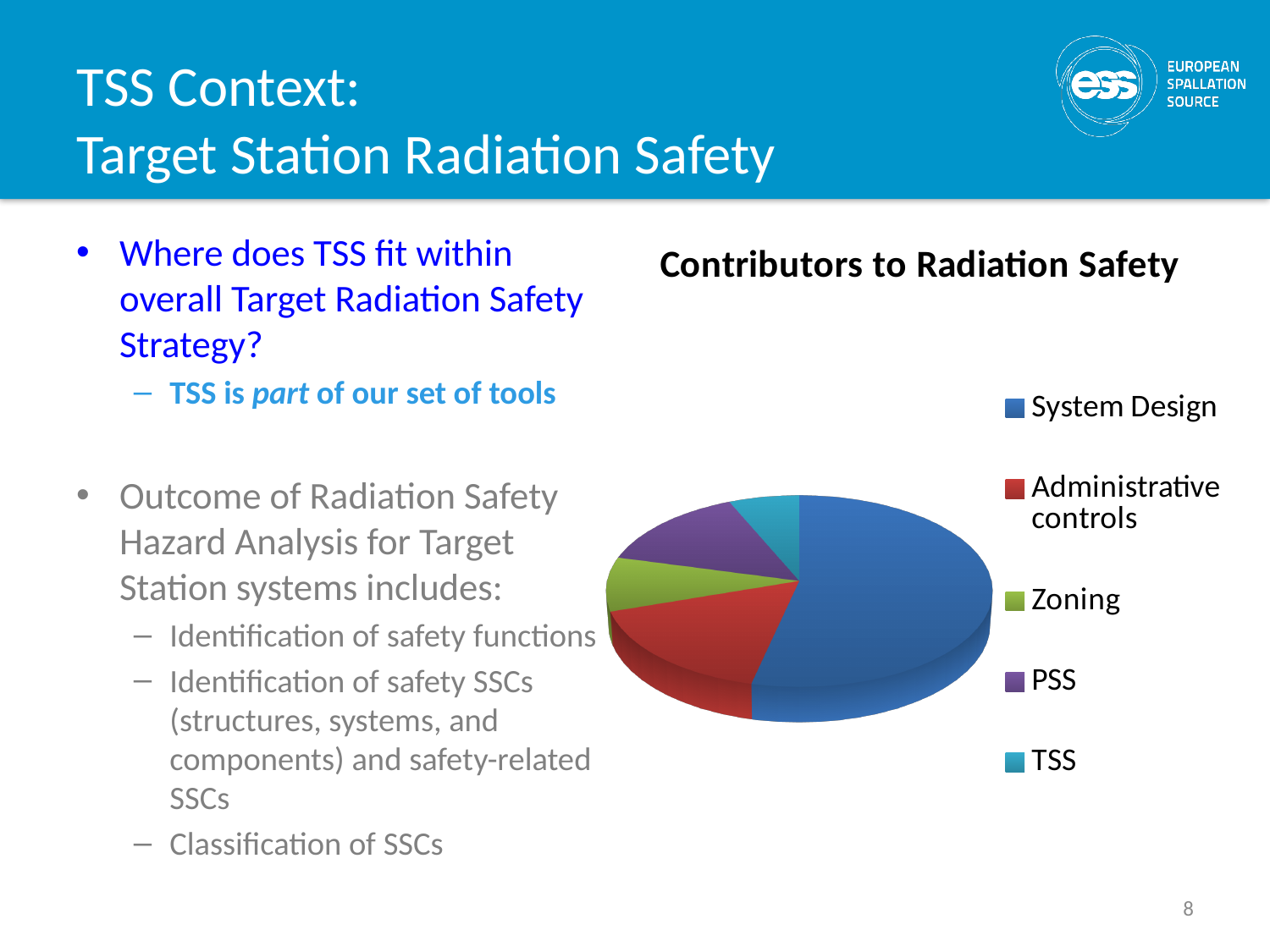
Which slice is larger, Administrative controls or TSS? Administrative controls Which category has the smallest slice of the pie? TSS How many categories does the pie chart show? 5 Which category has the largest slice of the pie? System Design Which category is shown in blue in the pie chart? System Design Which slice is larger, Administrative controls or Zoning? Administrative controls Which slice is larger, PSS or TSS? PSS What kind of chart is shown on the slide? pie chart What is the title of the chart? Contributors to Radiation Safety Which category is listed last in the chart legend? TSS